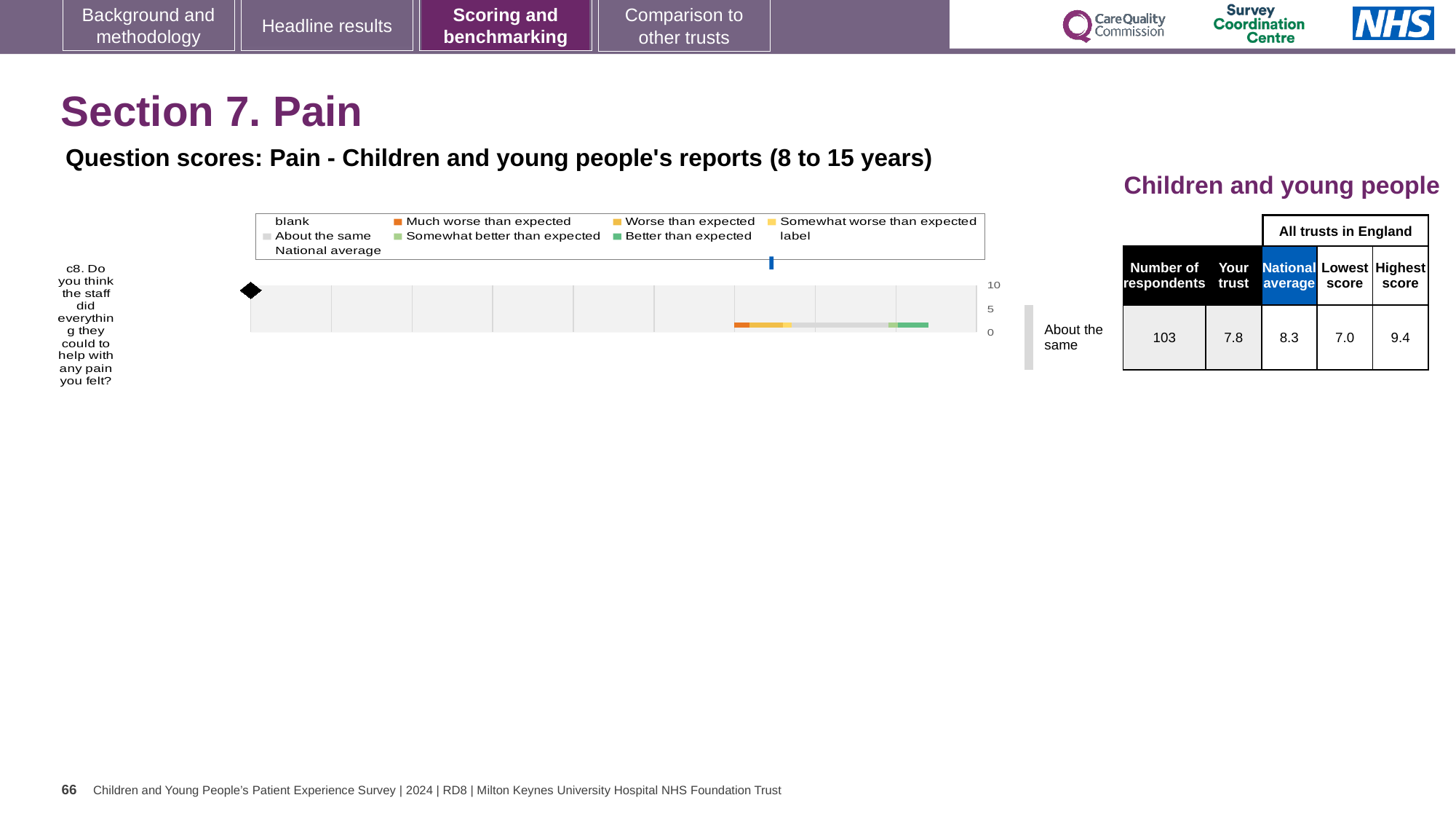
According to the table beside the chart, what is the highest score among all trusts in England for question c8? 9.4 What colour does the legend use for 'Much worse than expected'? orange What is the difference between the highest score (9.4) and the lowest score (7.0) for question c8? 2.4 How is the trust's result for question c8 categorised relative to expectation, as labelled next to the chart? About the same How many survey questions (categories) are plotted on the chart? 1 What kind of chart is shown on the slide? bar chart What is the highest value shown on the chart's axis? 10 According to the table beside the chart, what is the 'Your trust' score for question c8? 7.8 Which is larger for question c8: the 'Your trust' score or the national average? National average According to the table beside the chart, what is the lowest score among all trusts in England for question c8? 7.0 According to the table beside the chart, what is the national average score for question c8? 8.3 According to the table beside the chart, how many respondents answered question c8? 103